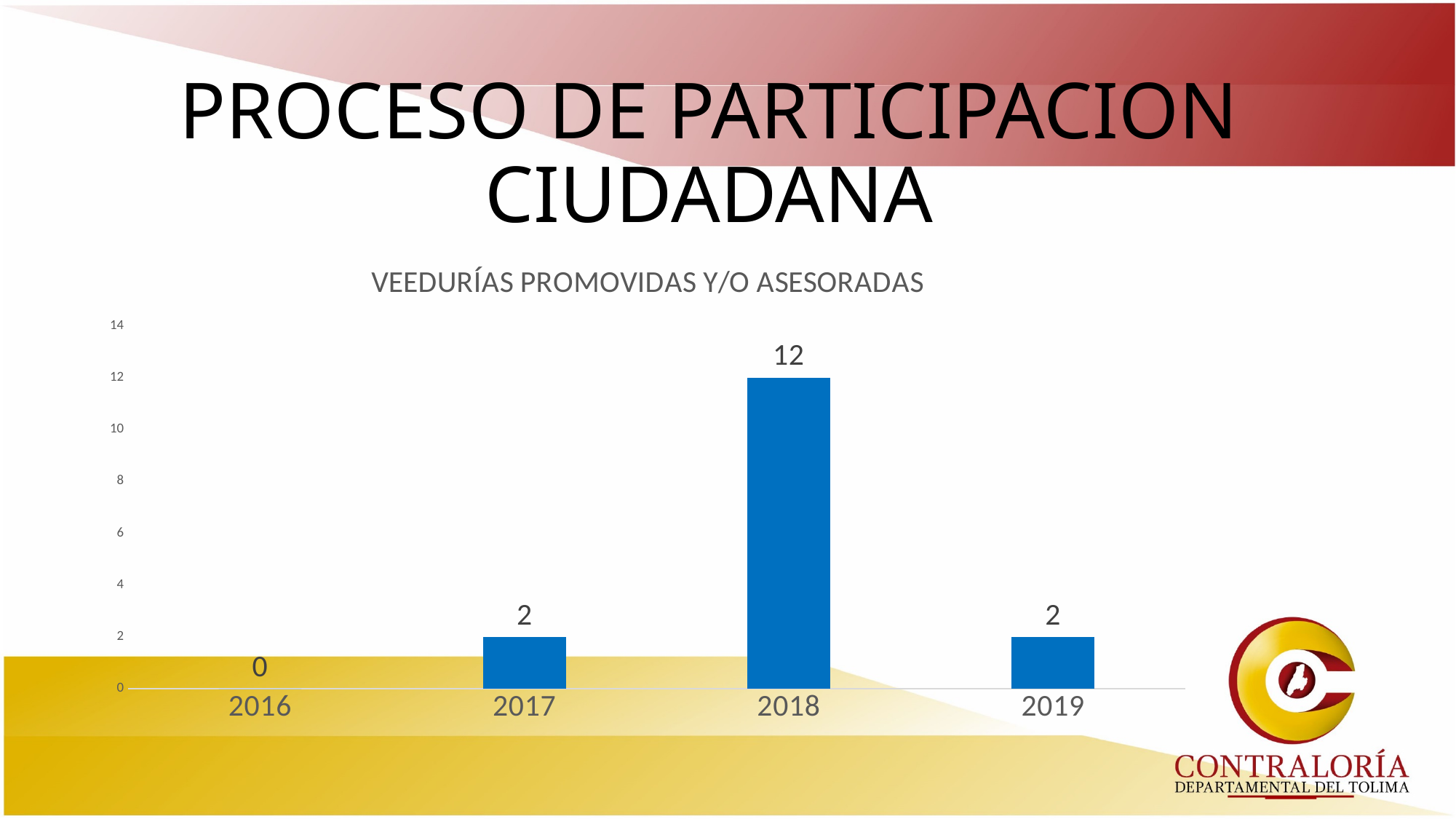
What is the difference between the values for 2018 and 2017? 10 What is the value for 2019? 2 How many years are shown on the x axis? 4 Which year has the lowest value? 2016 Which year has the highest value? 2018 Which is larger, the value for 2018 or the value for 2019? 2018 What is the title of the chart? VEEDURÍAS PROMOVIDAS Y/O ASESORADAS Is the value for 2018 greater or less than 10? greater What kind of chart is shown? bar chart What is the value for 2018? 12 What is the value for 2016? 0 What is the value for 2017? 2